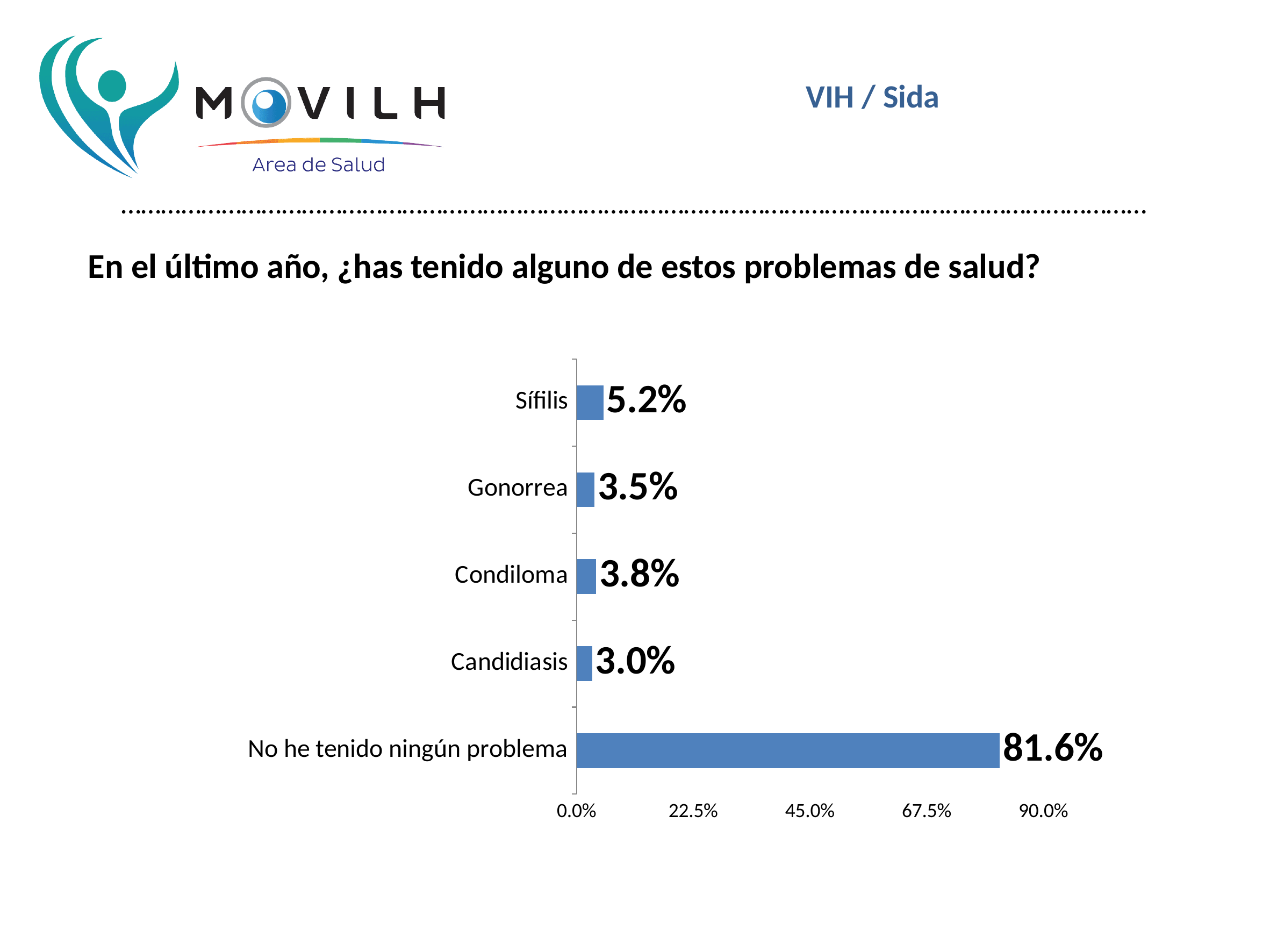
Which category has the lowest value? Candidiasis How many categories are shown in the chart? 5 What is the value for Condiloma? 3.8% Which category has the highest value? No he tenido ningún problema What is the difference between the values for Sífilis and Gonorrea? 1.7% What is the value for Sífilis? 5.2% What is the difference between the values for 'No he tenido ningún problema' and Sífilis? 76.4% What is the value for Gonorrea? 3.5% What is the value for 'No he tenido ningún problema'? 81.6% What is the value for Candidiasis? 3.0% Which is larger, the value for Condiloma or the value for Gonorrea? Condiloma What kind of chart is shown on the slide? Bar chart